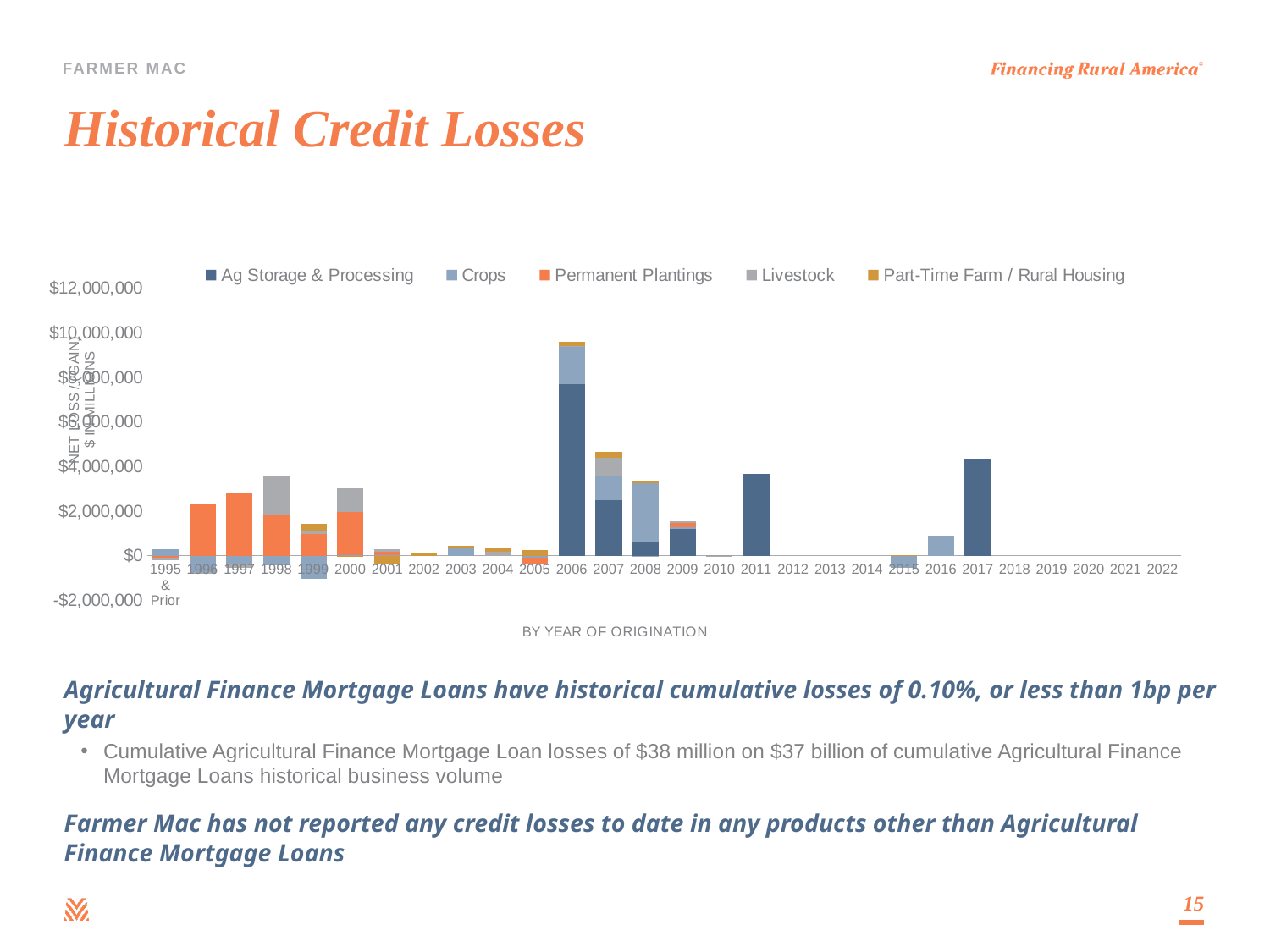
Is the total bar for 2016 greater or less than $2,000,000? less Is the total bar for 2006 greater or less than $8,000,000? greater Is the total bar for 2009 greater or less than $2,000,000? less What kind of chart is shown on the slide? Stacked bar chart Which year of origination has the highest total net loss bar? 2006 What is the x-axis title of the chart? BY YEAR OF ORIGINATION Which series makes up the entire bar for 2011? Ag Storage & Processing How many series does the legend list? 5 How many year categories are shown along the x axis? 28 Which has the larger total bar, 2006 or 2007? 2006